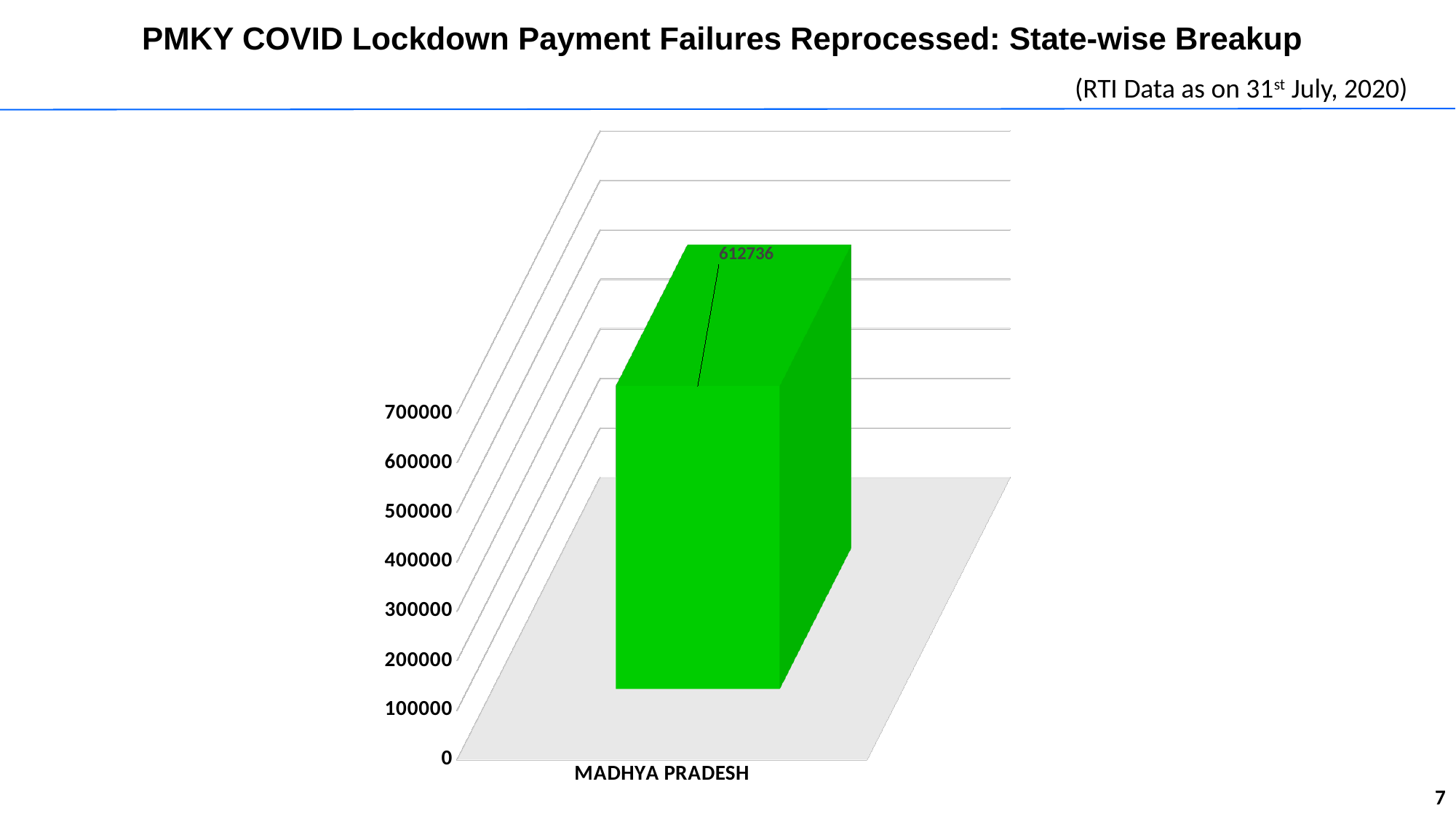
What is the value shown for Madhya Pradesh? 612736 Is the value for Madhya Pradesh greater or less than 700000? less Which state is shown on the x axis of the chart? Madhya Pradesh What is the title of the slide's chart? PMKY COVID Lockdown Payment Failures Reprocessed: State-wise Breakup What kind of chart is shown on the slide? bar chart Is the value for Madhya Pradesh greater or less than 600000? greater How many categories are plotted on the chart? 1 What is the highest value shown on the vertical axis? 700000